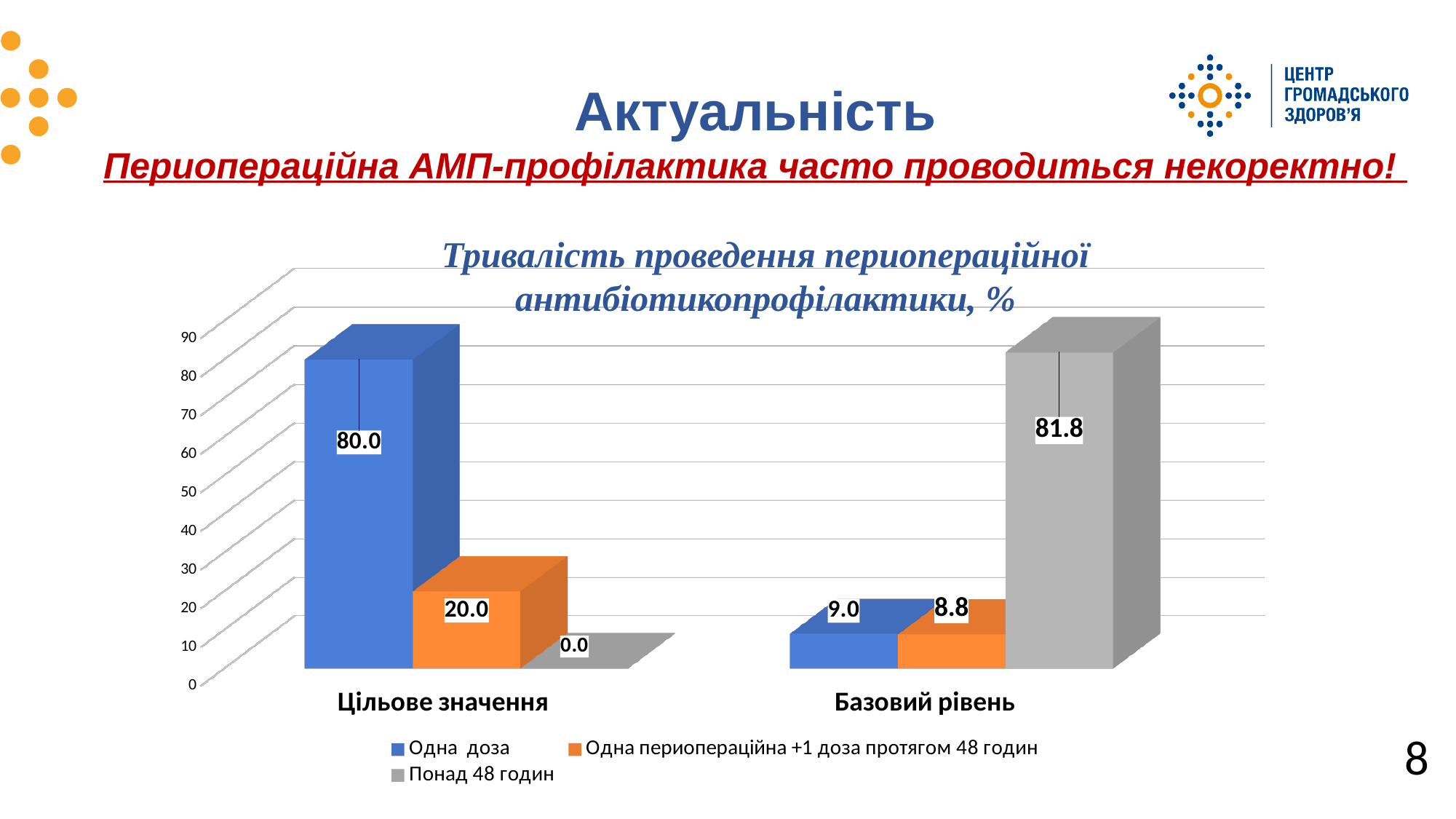
What is the value for "Понад 48 годин" in the "Цільове значення" category? 0.0 What is the value for "Понад 48 годин" in the "Базовий рівень" category? 81.8 What is the value for "Одна доза" in the "Цільове значення" category? 80.0 Which series has the highest value in the "Базовий рівень" category? Понад 48 годин How many series does the chart legend list? 3 How many categories are shown on the x axis of the chart? 2 What is the value for "Одна периопераційна +1 доза протягом 48 годин" in the "Цільове значення" category? 20.0 Which series has the lowest value in the "Цільове значення" category? Понад 48 годин What kind of chart is shown on the slide? Bar chart What is the value for "Одна доза" in the "Базовий рівень" category? 9.0 Which is larger: the "Одна доза" value for "Цільове значення" or the "Понад 48 годин" value for "Базовий рівень"? Понад 48 годин for Базовий рівень What is the difference between the "Одна доза" values for "Цільове значення" and "Базовий рівень"? 71.0